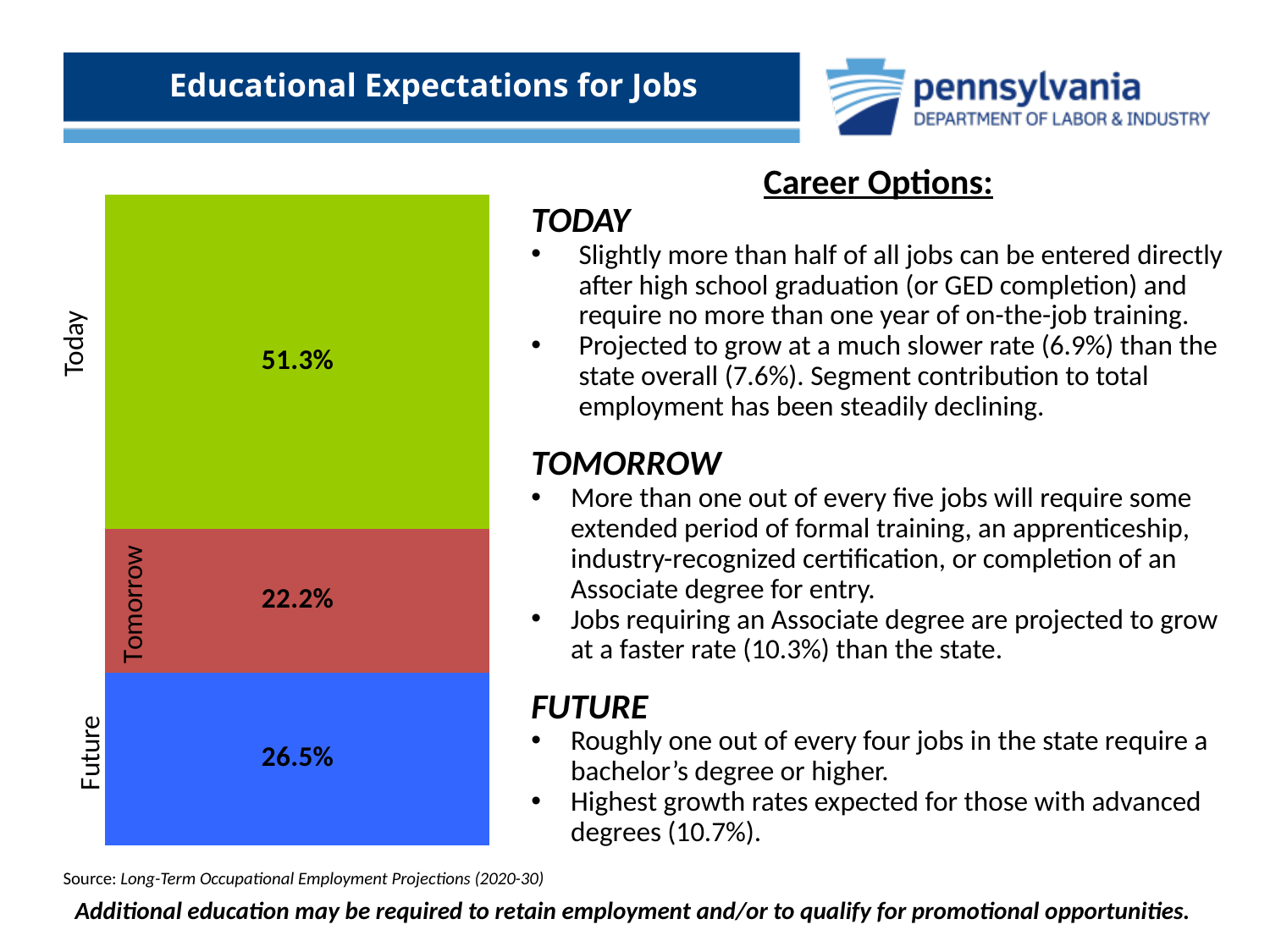
What type of chart is shown on the slide? Stacked bar chart How many segments make up the stacked bar? 3 Which segment of the stacked bar has the largest value? Today What is the total of the three segments in the stacked bar? 100.0% What percentage is shown for the Today segment of the stacked bar? 51.3% What colour is the Today segment of the stacked bar? Green Which segment of the stacked bar has the smallest value? Tomorrow What percentage is shown for the Future segment of the stacked bar? 26.5% What is the difference between the Today and Future percentages? 24.8% What is the difference between the Future and Tomorrow percentages? 4.3% Which is larger, the Future segment or the Tomorrow segment? Future What percentage is shown for the Tomorrow segment of the stacked bar? 22.2%